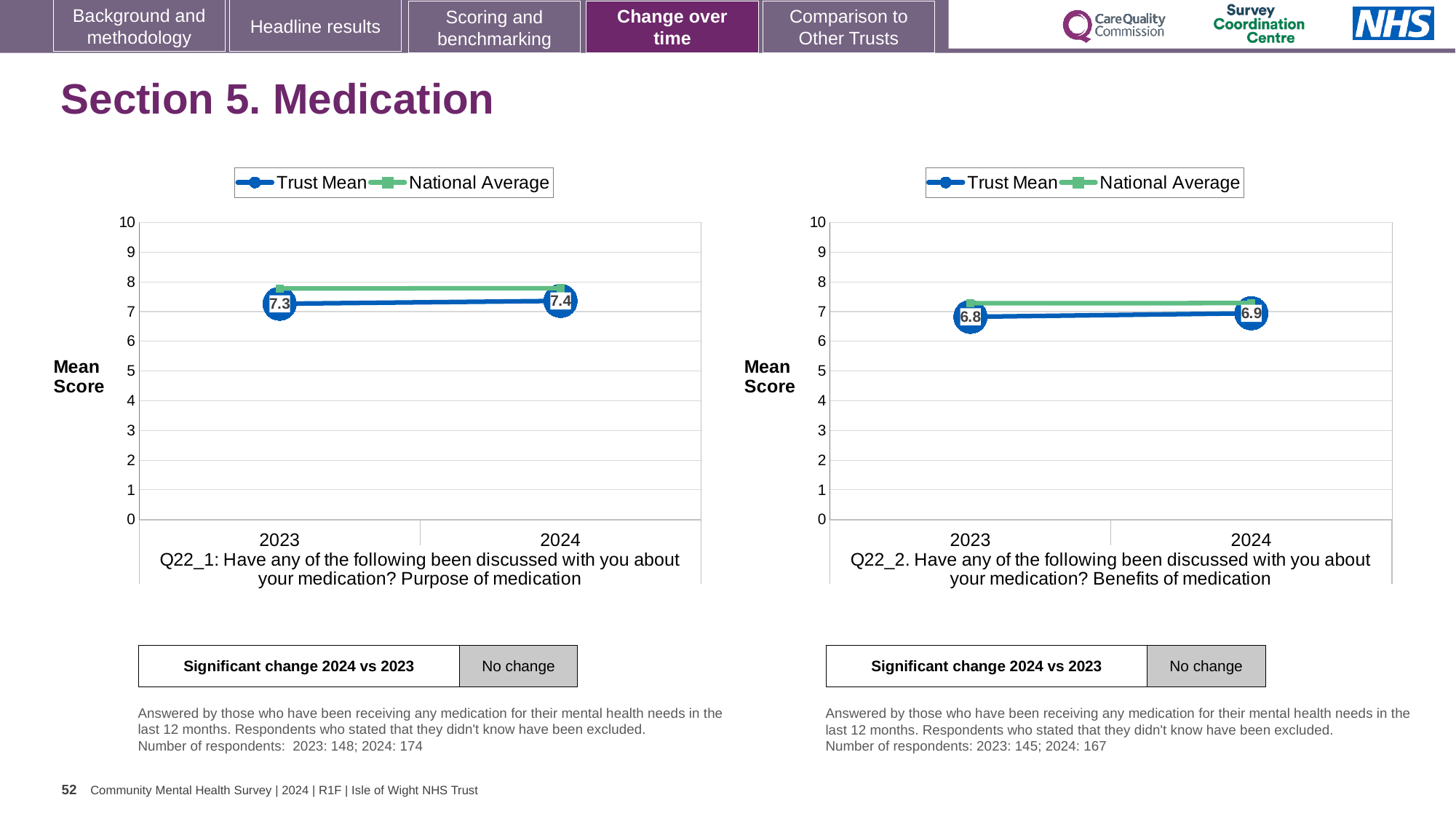
In the right chart (Q22_2: Benefits of medication), what is the Trust Mean score for 2024? 6.9 In the left chart (Q22_1: Purpose of medication), by how much did the Trust Mean change from 2023 to 2024? 0.1 In the left chart (Q22_1: Purpose of medication), what is the Trust Mean score for 2024? 7.4 In the right chart (Q22_2: Benefits of medication), which is higher in 2023, the Trust Mean or the National Average? National Average In the left chart (Q22_1: Purpose of medication), what is the Trust Mean score for 2023? 7.3 How many series does the legend of the right chart (Q22_2: Benefits of medication) list? 2 In the right chart (Q22_2: Benefits of medication), what is the Trust Mean score for 2023? 6.8 In the right chart (Q22_2: Benefits of medication), does the Trust Mean rise or fall from 2023 to 2024? rise What does the y axis of the right chart (Q22_2: Benefits of medication) represent? Mean Score In the left chart (Q22_1: Purpose of medication), is the National Average for 2023 greater or less than 7? greater How many years are plotted on the x axis of the left chart (Q22_1: Purpose of medication)? 2 What kind of chart is the left chart (Q22_1: Purpose of medication)? line chart